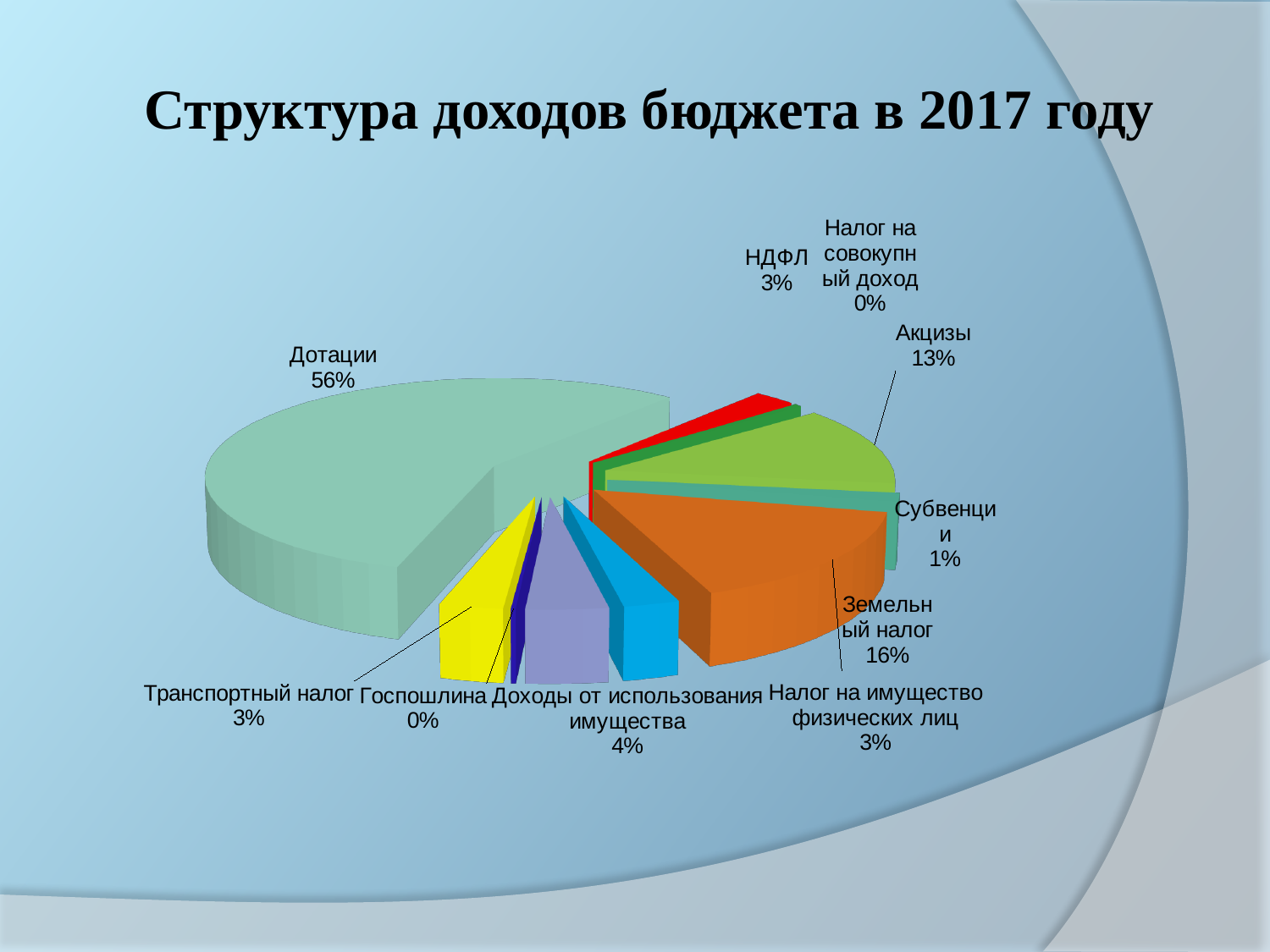
What share of the pie is Доходы от использования имущества? 4% What share of the pie is Земельный налог? 16% What share of the pie is Субвенции? 1% How many categories are shown in the pie chart? 10 What is the title of the chart? Структура доходов бюджета в 2017 году Which category has the largest share of the pie? Дотации What is the difference between the shares of Дотации and Земельный налог? 40% What kind of chart is shown on the slide? Pie chart Which is larger, the share of Акцизы or the share of Земельный налог? Земельный налог